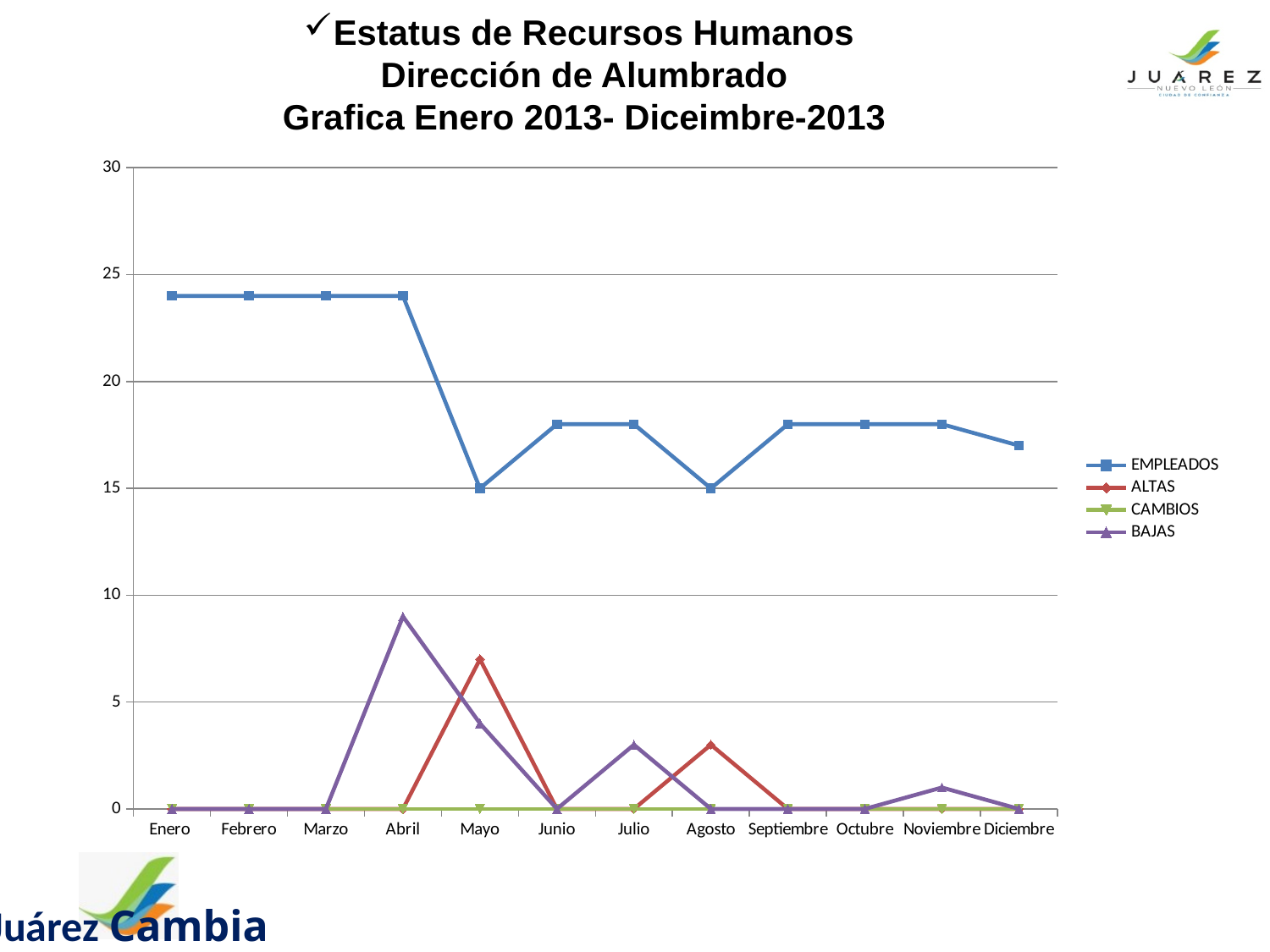
How many months are shown along the x axis? 12 What kind of chart is shown on the slide? line chart In which month is ALTAS highest? Mayo What is the value of EMPLEADOS in Mayo? 15 How many series does the legend list? 4 Is the value of EMPLEADOS in Enero greater or less than 20? greater Does the EMPLEADOS series rise or fall overall from Enero to Diciembre? fall In Abril, which is larger, BAJAS or ALTAS? BAJAS In which month is BAJAS highest? Abril Is the value of EMPLEADOS in Diciembre greater or less than 20? less What is the value of ALTAS in Enero? 0 Is the value of BAJAS in Abril greater or less than 5? greater